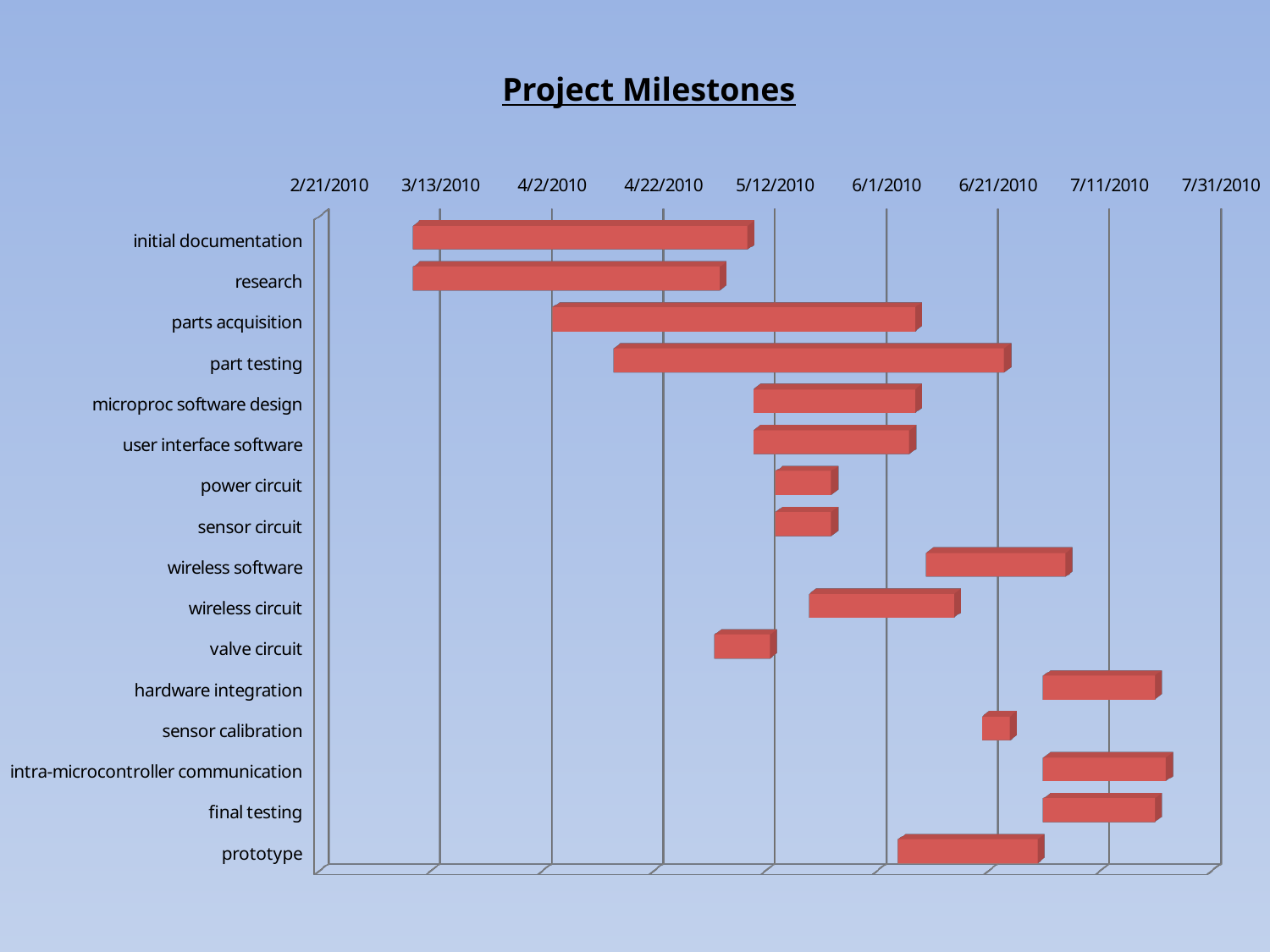
Which task has the longest bar in the chart? part testing Which task has a longer bar, valve circuit or wireless software? wireless software Which task has the shortest bar in the chart? sensor calibration Does the bar for wireless software start before or after 6/1/2010? after Which task has a longer bar, power circuit or wireless circuit? wireless circuit Does the bar for hardware integration start before or after 6/21/2010? after Does the bar for research end before or after 5/12/2010? before What is the title of the chart? Project Milestones What is the last date shown on the horizontal axis? 7/31/2010 What kind of chart is shown on the slide? bar chart How many tasks are listed on the vertical axis of the chart? 16